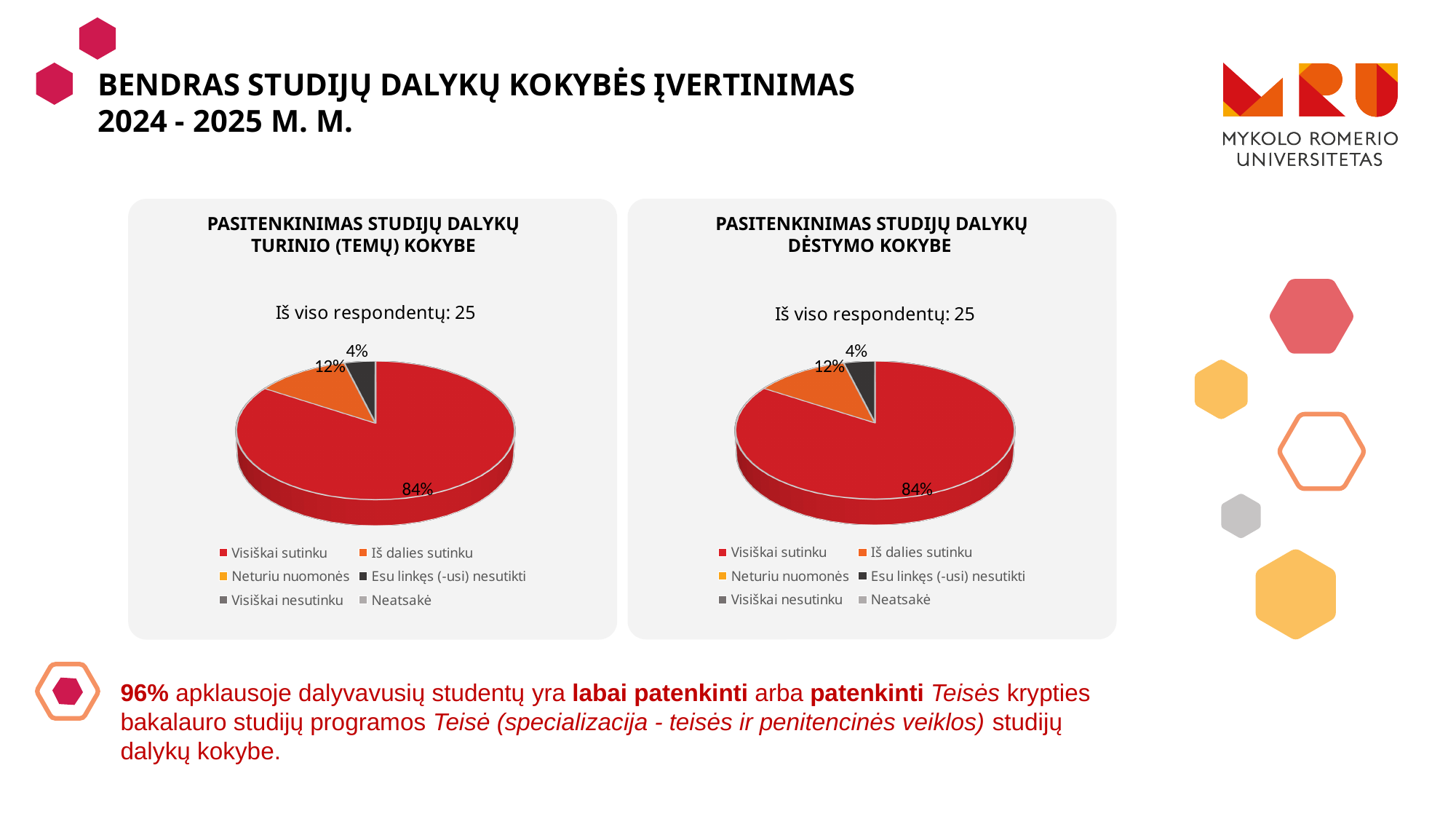
In the right chart, 'Pasitenkinimas studijų dalykų dėstymo kokybe', what share of respondents answered 'Visiškai sutinku'? 84% In the left chart, 'Pasitenkinimas studijų dalykų turinio (temų) kokybe', which category has the largest slice? Visiškai sutinku In the right chart, 'Pasitenkinimas studijų dalykų dėstymo kokybe', what share of respondents answered 'Esu linkęs (-usi) nesutikti'? 4% In the left chart, 'Pasitenkinimas studijų dalykų turinio (temų) kokybe', what colour is the 'Visiškai sutinku' slice? Red In the right chart, 'Pasitenkinimas studijų dalykų dėstymo kokybe', which is larger: 'Iš dalies sutinku' or 'Esu linkęs (-usi) nesutikti'? Iš dalies sutinku In the left chart, 'Pasitenkinimas studijų dalykų turinio (temų) kokybe', what is the difference between the 'Visiškai sutinku' and 'Iš dalies sutinku' shares? 72% How many entries does the legend of the right chart, 'Pasitenkinimas studijų dalykų dėstymo kokybe', list? 6 How many respondents does the left chart, 'Pasitenkinimas studijų dalykų turinio (temų) kokybe', report in total? 25 In the left chart, 'Pasitenkinimas studijų dalykų turinio (temų) kokybe', what share of respondents answered 'Visiškai sutinku'? 84% In the right chart, 'Pasitenkinimas studijų dalykų dėstymo kokybe', which of the labelled slices is the smallest? Esu linkęs (-usi) nesutikti What kind of chart is the left chart, 'Pasitenkinimas studijų dalykų turinio (temų) kokybe'? Pie chart